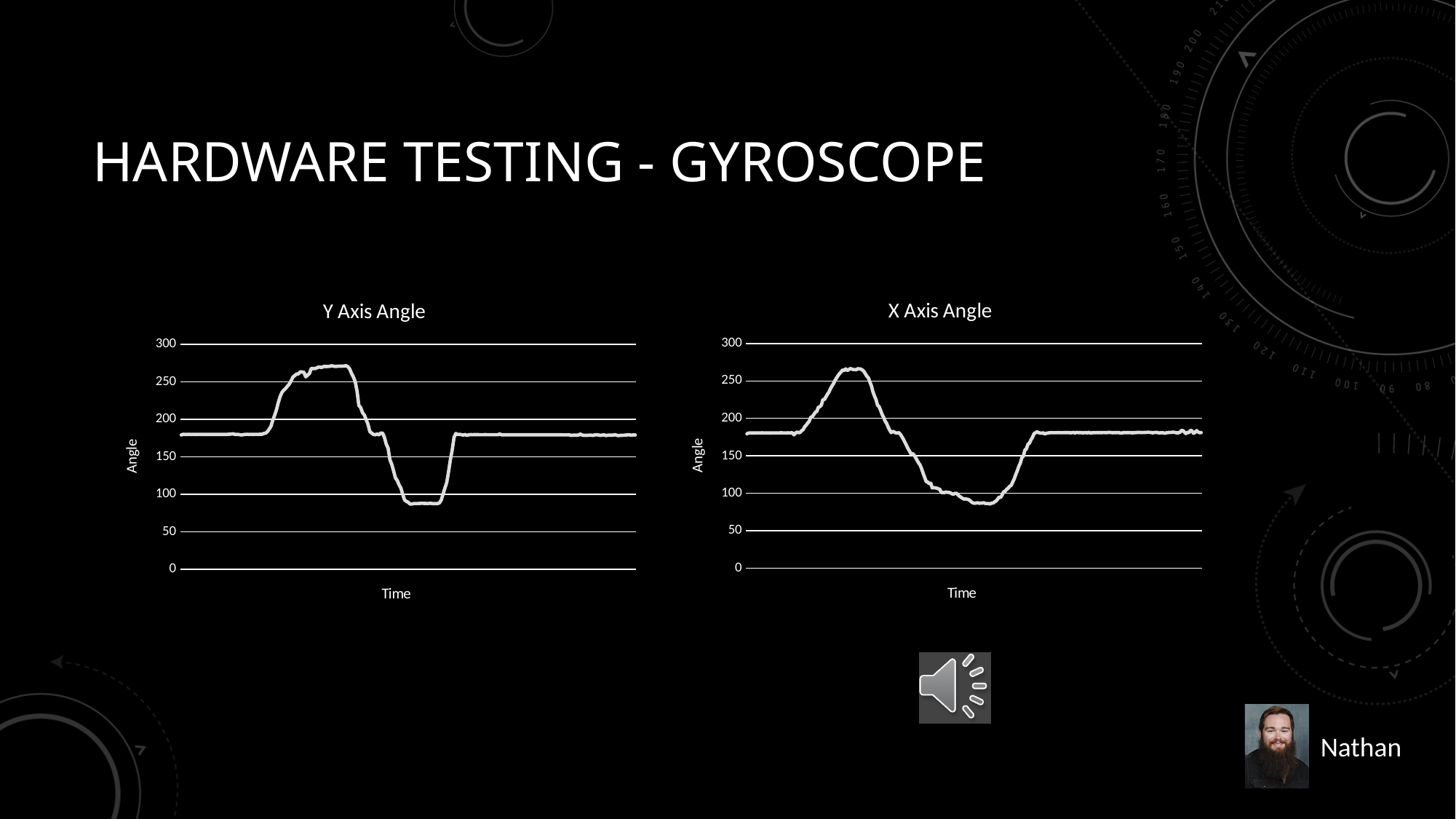
In the "X Axis Angle" chart, is the lowest value reached by the line greater or less than 100? less In the "X Axis Angle" chart, is the highest value reached by the line greater or less than 250? greater In the "Y Axis Angle" chart, is the value at the end of the line greater or less than 150? greater What is the label of the horizontal axis on the "X Axis Angle" chart? Time What kind of chart is the "Y Axis Angle" chart? line chart In the "X Axis Angle" chart, does the line rise or fall immediately after its peak? fall What kind of chart is the "X Axis Angle" chart? line chart What is the title of the chart on the left? Y Axis Angle How many charts are shown on the slide? 2